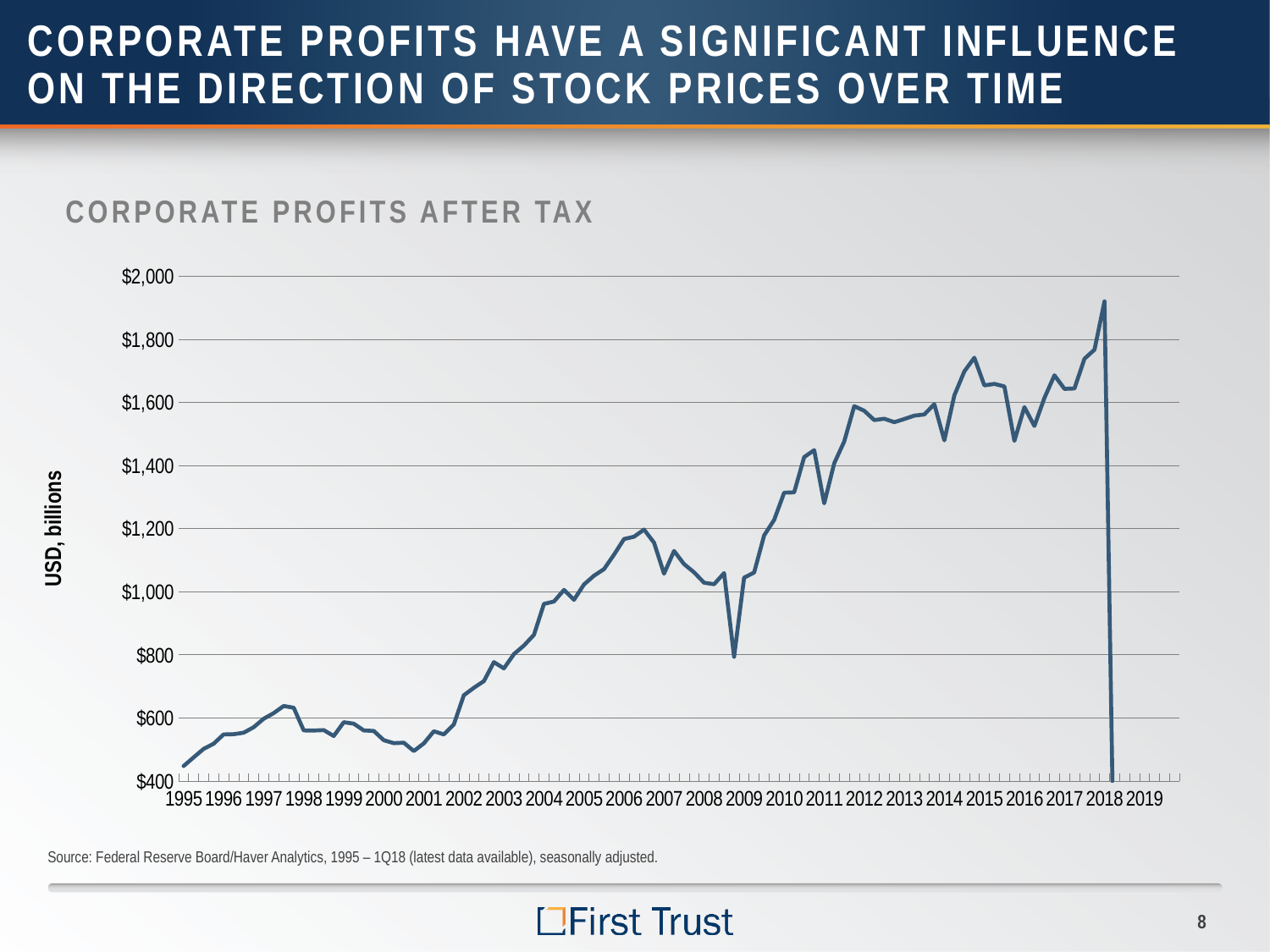
How many year labels are shown on the x axis? 25 In which year does the line reach its highest point? 2018 What is the title of the chart? Corporate Profits After Tax Is the value in 2012 greater or less than $1,400? greater What is the label on the vertical axis of the chart? USD, billions What kind of chart is shown on the slide? Line chart Is the value in 2015 greater or less than $1,400? greater Is the value at the start of 1995 greater or less than $600? less Overall, do corporate profits after tax rise or fall from 1995 to 2018? Rise